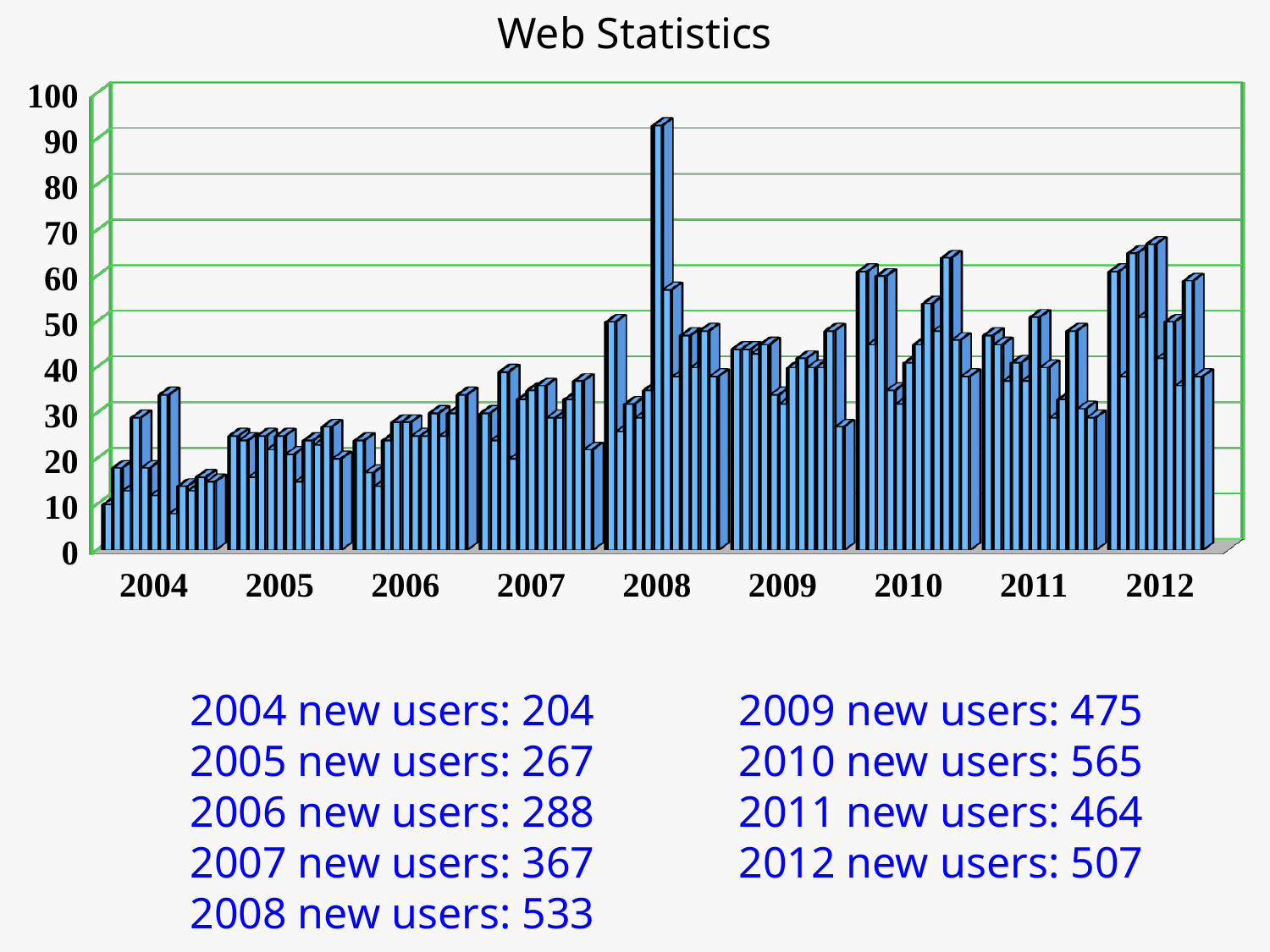
According to the text below the chart, what is the difference in new users between 2008 and 2007? 166 What is the title of the chart? Web Statistics According to the text below the chart, which year had the fewest new users? 2004 Is the tallest bar in the 2012 group greater or less than 60? greater How many years are labelled along the x axis of the chart? 9 In which year does the tallest bar in the chart appear? 2008 Are all the bars in the 2004 group greater or less than 40? less What kind of chart is shown on the slide? bar chart According to the text below the chart, how many new users were there in 2010? 565 What is the highest value shown on the vertical axis of the chart? 100 Which is taller: the tallest bar in 2008 or the tallest bar in 2012? 2008 Is the tallest bar in the chart greater or less than 90? greater